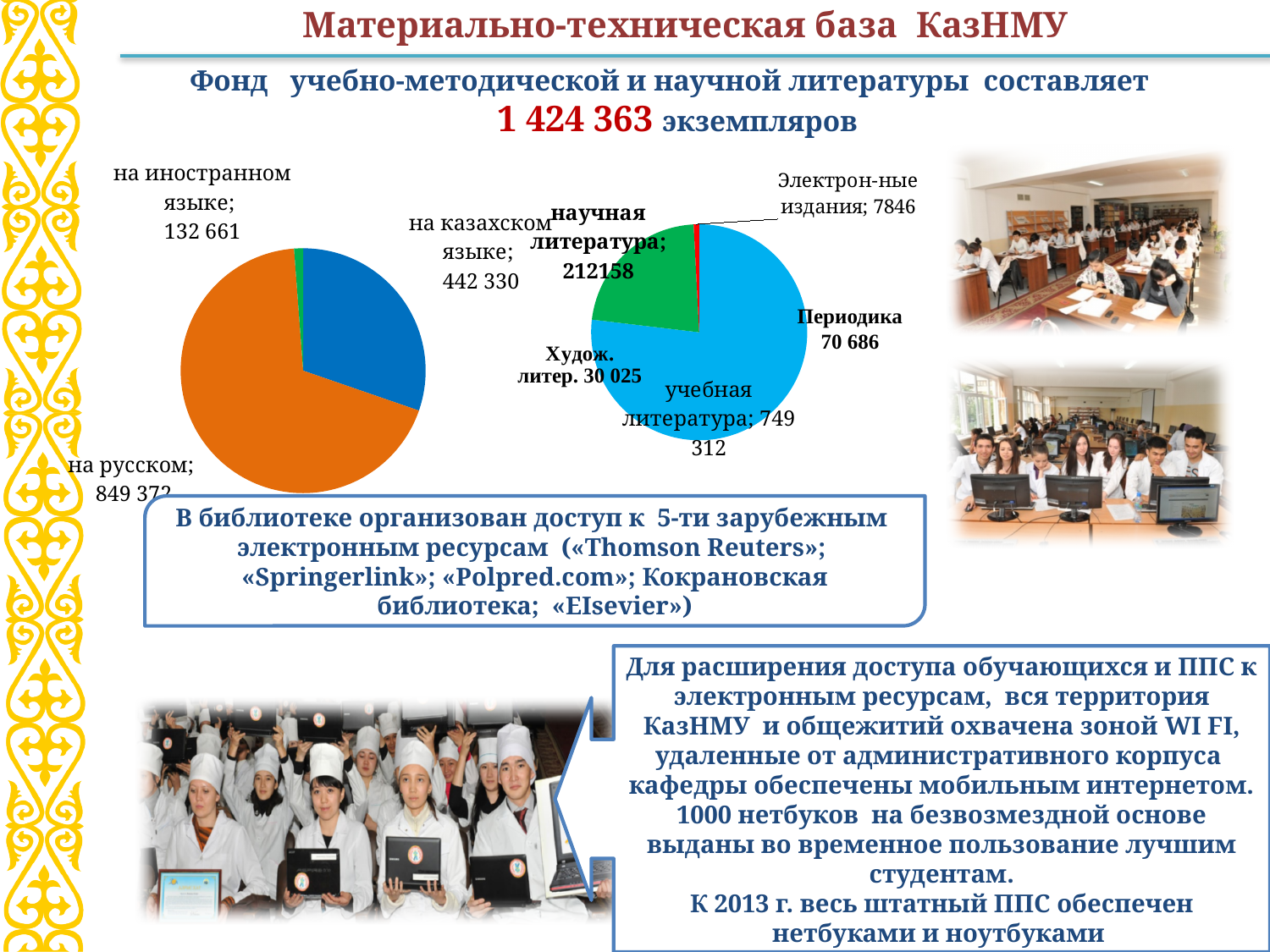
On the left pie chart, which category has the largest slice? на русском On the right pie chart, which is larger: 'Худож. литер.' or 'Периодика'? Периодика On the right pie chart, what is the value for 'учебная литература'? 749 312 What type of chart is the right chart on the slide? pie chart On the right pie chart, what is the value for 'Периодика'? 70 686 On the left pie chart, which category has the smallest slice? на иностранном языке On the left pie chart, what is the value for 'на казахском языке'? 442 330 On the left pie chart, how many categories are shown? 3 On the left pie chart, what is the value for 'на иностранном языке'? 132 661 On the right pie chart, which category has the smallest value? Электронные издания On the right pie chart, what is the value for 'Электронные издания'? 7846 On the left pie chart, what is the difference between the values for 'на казахском языке' and 'на иностранном языке'? 309 669